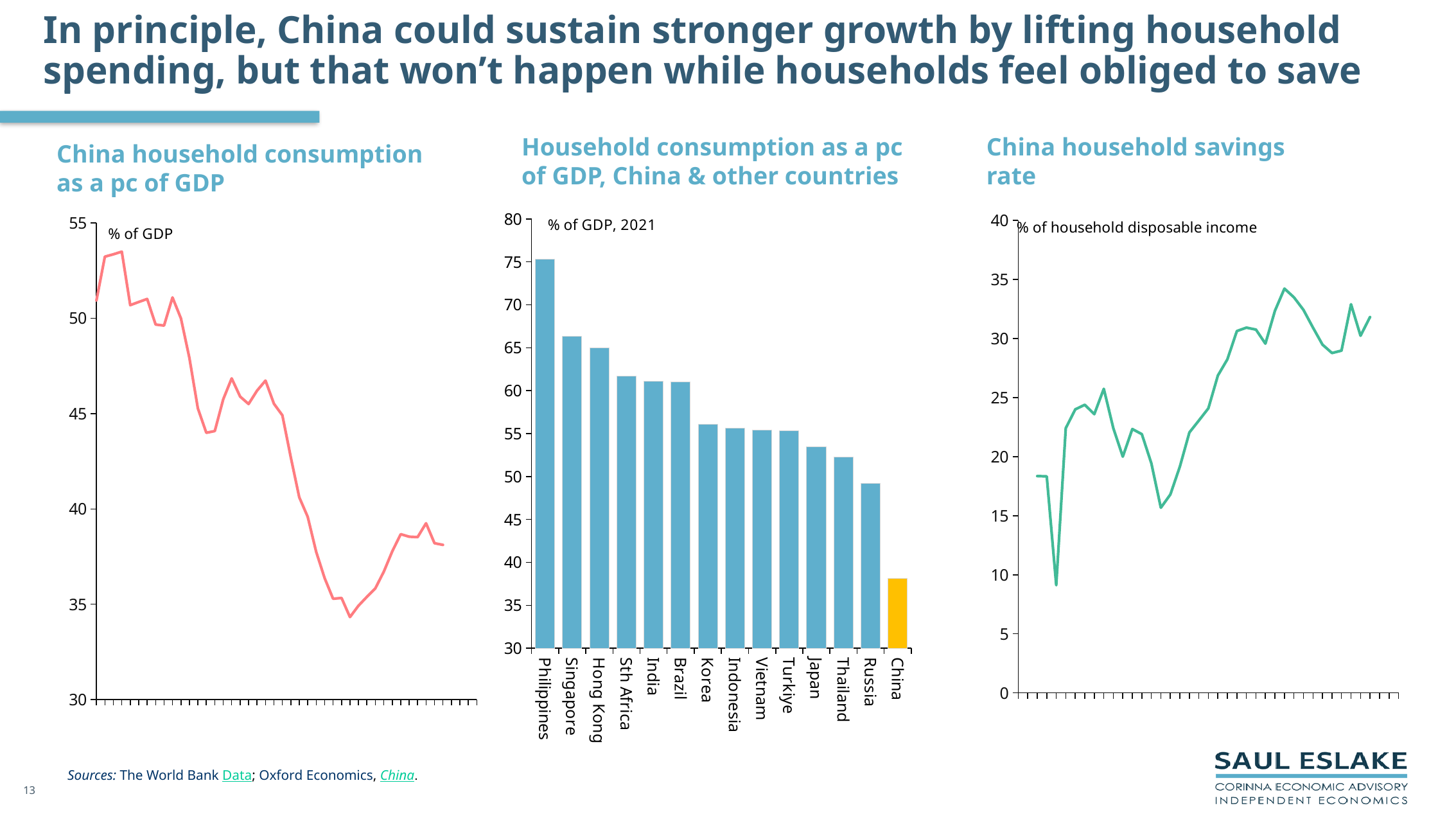
In the left chart, 'China household consumption as a pc of GDP', do the values generally rise or fall along the x axis? fall In the right chart, 'China household savings rate', do the values generally rise or fall along the x axis? rise In the middle chart, 'Household consumption as a pc of GDP, China & other countries', how many countries are shown? 14 In the middle chart, 'Household consumption as a pc of GDP, China & other countries', is the value for China greater or less than 40? less In the middle chart, 'Household consumption as a pc of GDP, China & other countries', which is larger, the value for Sth Africa or the value for Thailand? Sth Africa In the middle chart, 'Household consumption as a pc of GDP, China & other countries', is the value for Philippines greater or less than 70? greater In the middle chart, 'Household consumption as a pc of GDP, China & other countries', which country has the highest value? Philippines In the middle chart, 'Household consumption as a pc of GDP, China & other countries', is the value for Japan greater or less than 50? greater In the middle chart, 'Household consumption as a pc of GDP, China & other countries', which country has the lowest value? China In the middle chart, 'Household consumption as a pc of GDP, China & other countries', which is larger, the value for Singapore or the value for Korea? Singapore In the middle chart, 'Household consumption as a pc of GDP, China & other countries', what colour is the bar for China? yellow What kind of chart is the middle chart, 'Household consumption as a pc of GDP, China & other countries'? bar chart